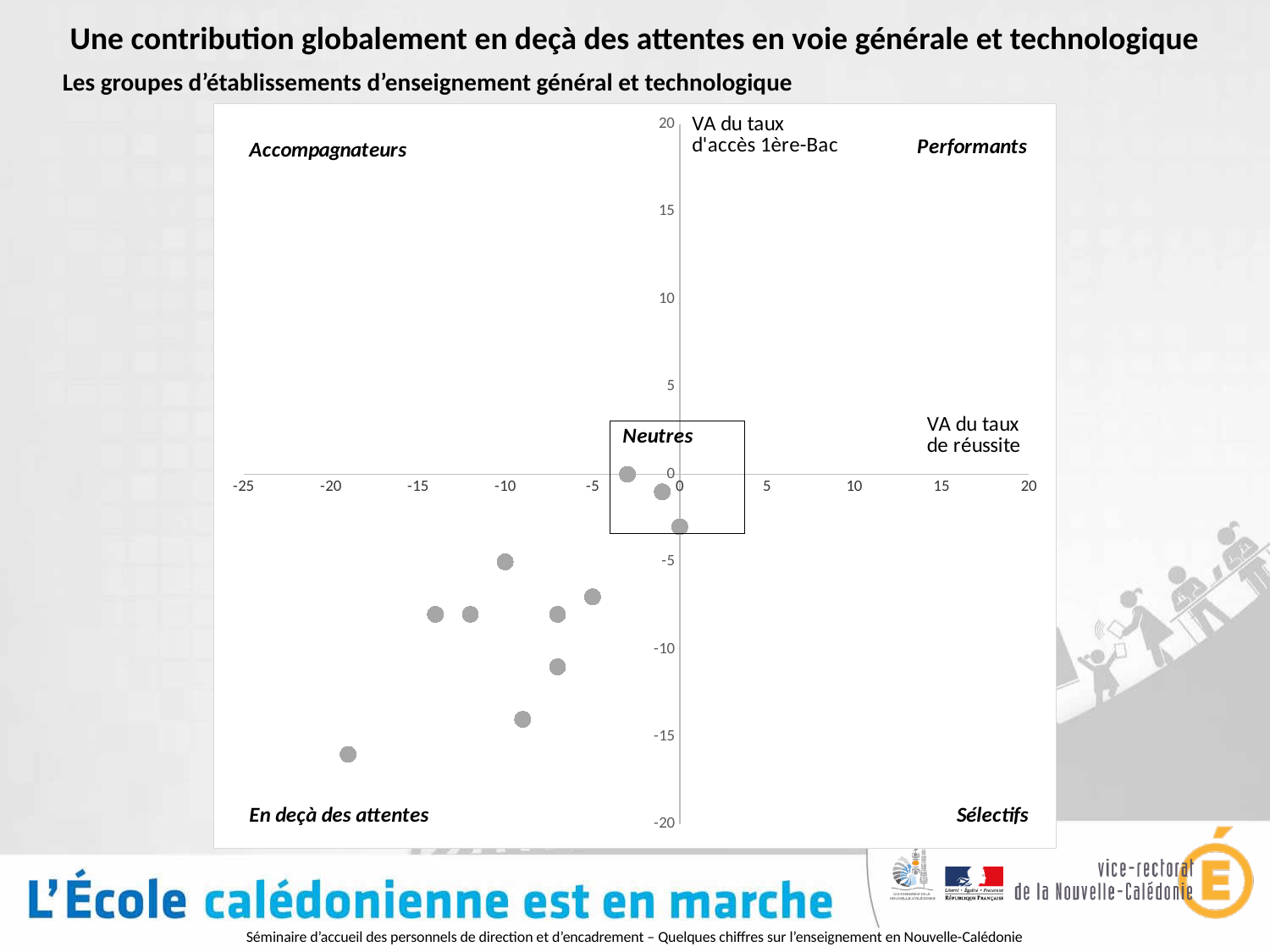
Which quadrant of the chart contains the most data points? En deçà des attentes What kind of chart is shown on the slide? scatter chart How many data points are plotted on the chart? 11 What is the label of the vertical axis of the chart? VA du taux d'accès 1ère-Bac How many data points are plotted in the 'Performants' quadrant? 0 What is the label of the horizontal axis of the chart? VA du taux de réussite How many data points lie inside the box labelled 'Neutres'? 3